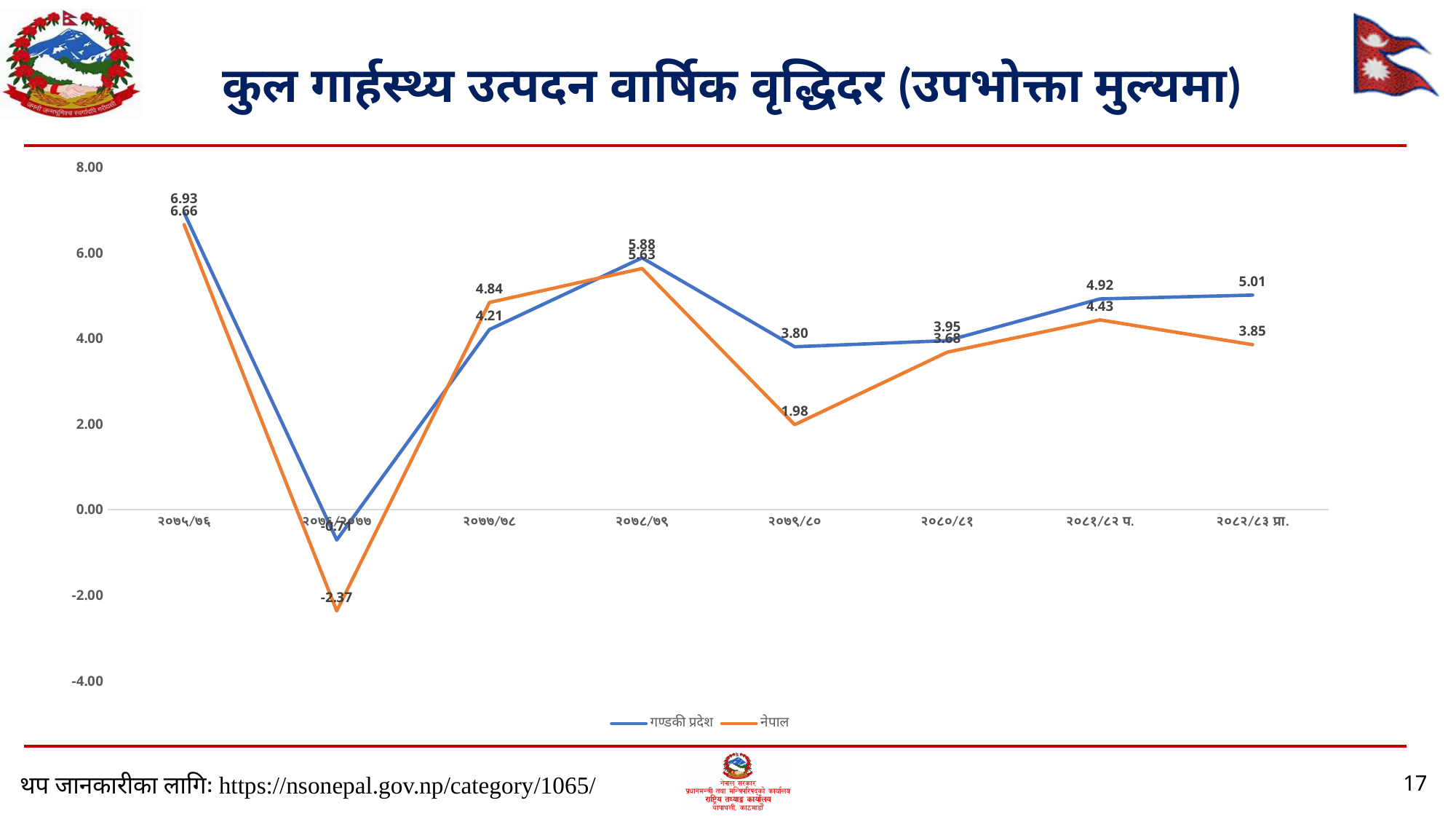
What is the value for गण्डकी प्रदेश in २०८२/८३ प्रा.? 5.01 Which series has the larger value in २०७७/७८, गण्डकी प्रदेश or नेपाल? नेपाल What is the value for नेपाल in २०७९/८०? 1.98 In which category is the value for नेपाल lowest? २०७६/२०७७ Which series is drawn in orange? नेपाल How many categories are shown on the x axis? 8 What type of chart is shown on the slide? line chart How many series does the legend list? 2 What is the value for नेपाल in २०७६/७७? -2.37 In which category is the value for गण्डकी प्रदेश highest? २०७५/७६ What is the value for गण्डकी प्रदेश in २०७५/७६? 6.93 What is the difference between गण्डकी प्रदेश and नेपाल in २०७९/८०? 1.82